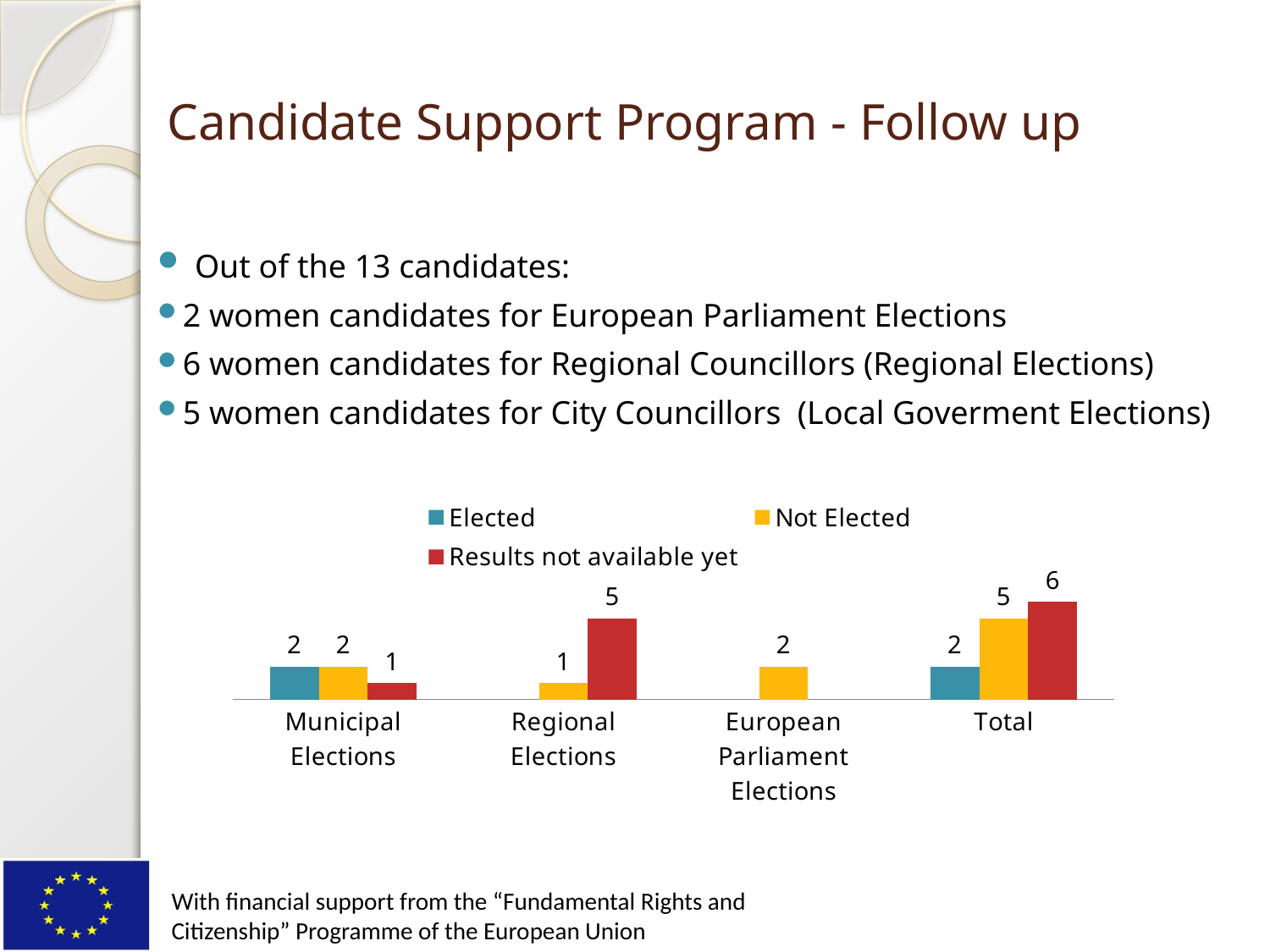
What is the Results not available yet value for Regional Elections? 5 What kind of chart is shown on the slide? Bar chart What is the Not Elected value for Total? 5 Which category has the highest Results not available yet value? Total How many series does the legend list? 3 How many categories are shown on the x axis? 4 What is the difference between the Results not available yet value and the Elected value for Total? 4 Which series has the lowest value in the Total category? Elected What is the Elected value for Municipal Elections? 2 Which is larger for Regional Elections: Not Elected or Results not available yet? Results not available yet What is the Not Elected value for European Parliament Elections? 2 Which series is shown in red in the legend? Results not available yet